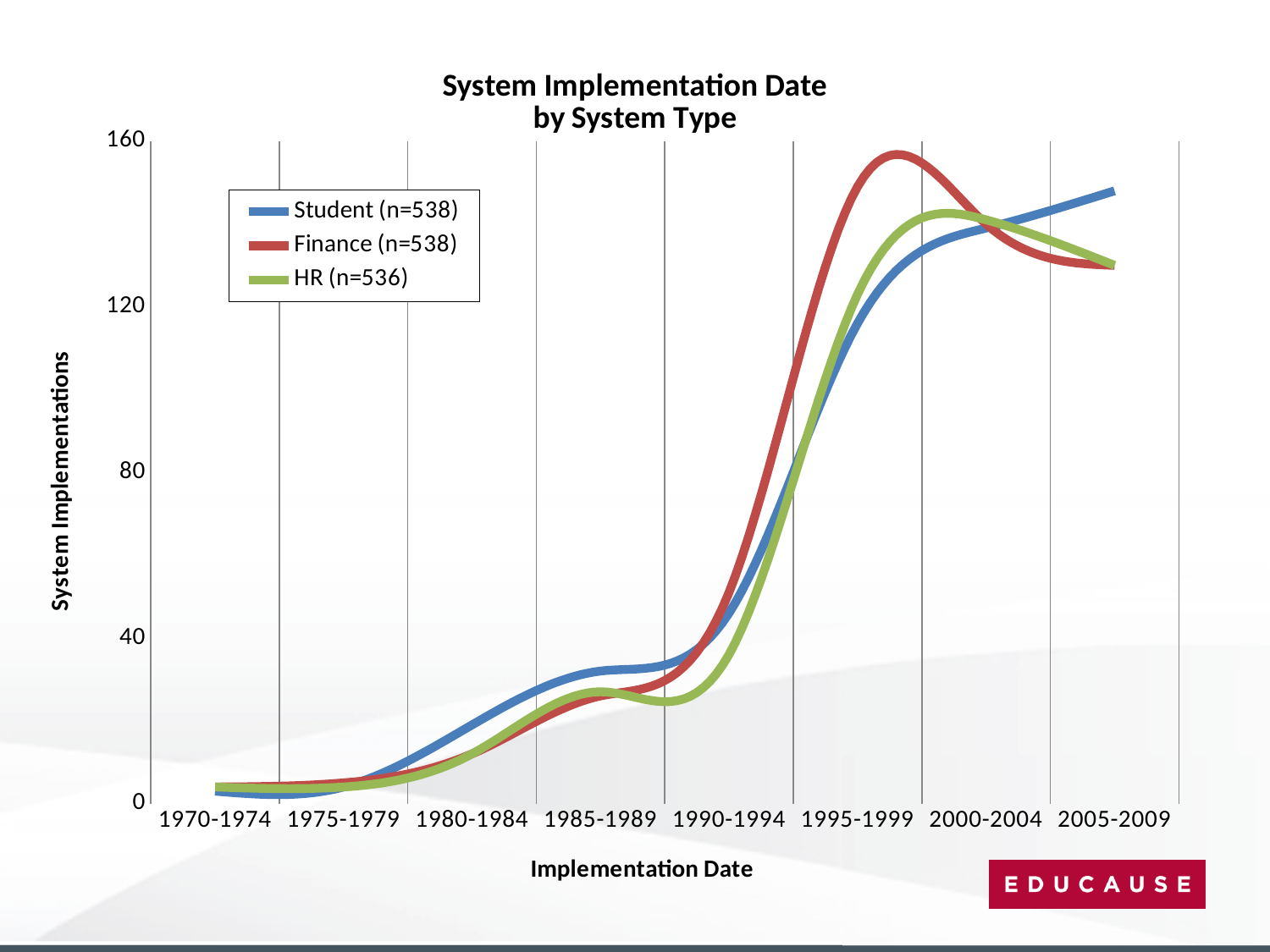
How many series does the legend list? 3 What is the title of the chart? System Implementation Date by System Type Is the value for Finance in 1990-1994 greater or less than 40? greater Which series has the highest value in 2000-2004? HR (n=536) Is the value for HR in 2000-2004 greater or less than 120? greater Which series is drawn in green? HR (n=536) How many implementation date periods are shown on the x axis? 8 In 1995-1999, which is larger: the Finance value or the Student value? Finance Is the value for Student in 2005-2009 greater or less than 120? greater What kind of chart is shown on the slide? line chart Does the Finance series rise or fall from 2000-2004 to 2005-2009? fall Which series has the highest value in 2005-2009? Student (n=538)